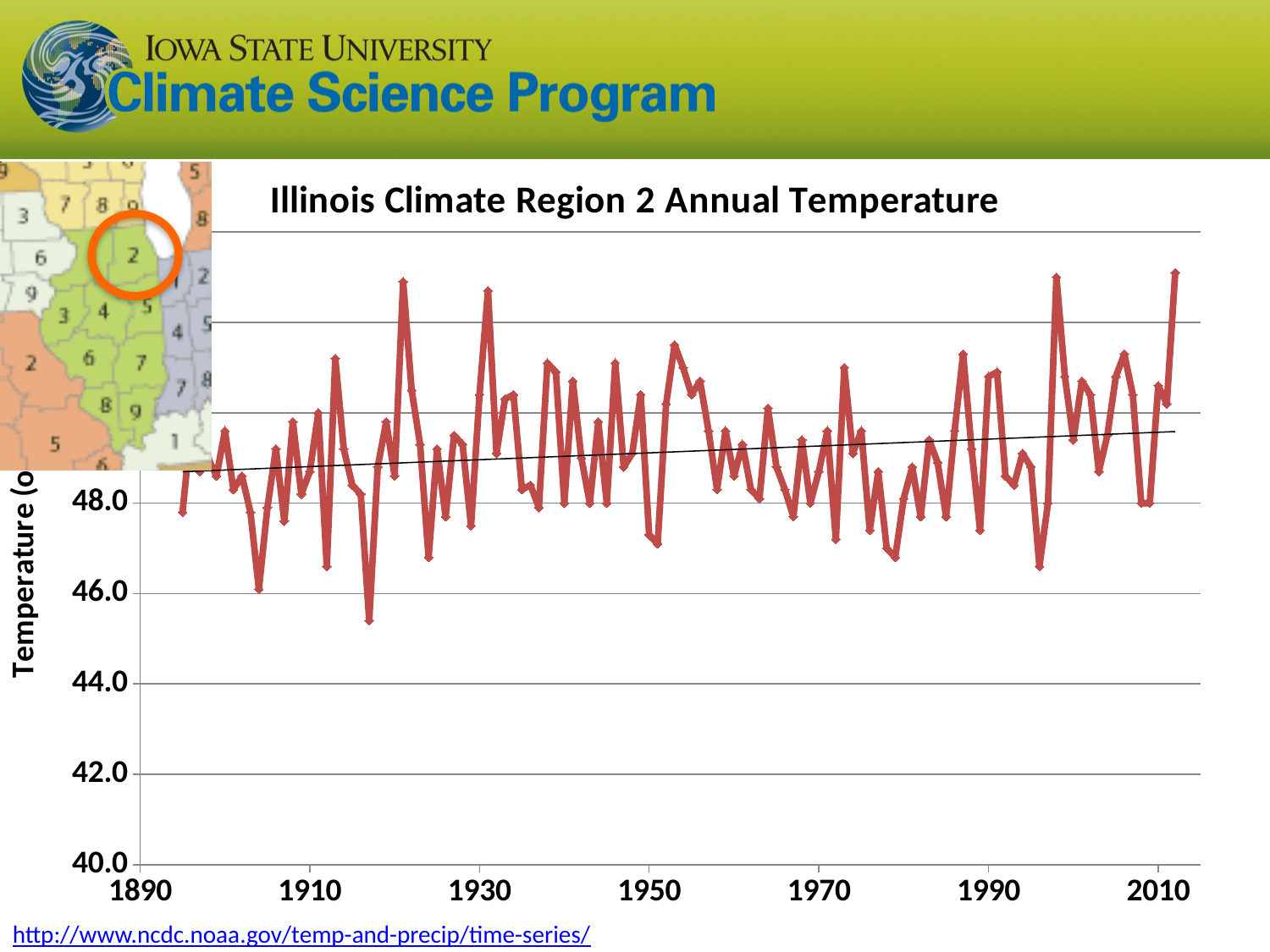
Is the lowest point on the chart located before or after 1930 on the x axis? before Is the peak near 1921 greater or less than 48.0? greater What is the title of the chart? Illinois Climate Region 2 Annual Temperature What is the lowest value labeled on the y axis? 40.0 What kind of chart is shown on the slide? line chart Is the dip near 1996 greater or less than 48.0? less Does the fitted trend line on the chart rise or fall from 1890 to 2010? rises Is the lowest point on the chart (around 1917) greater or less than 46.0? less How many year labels are printed along the x axis? 7